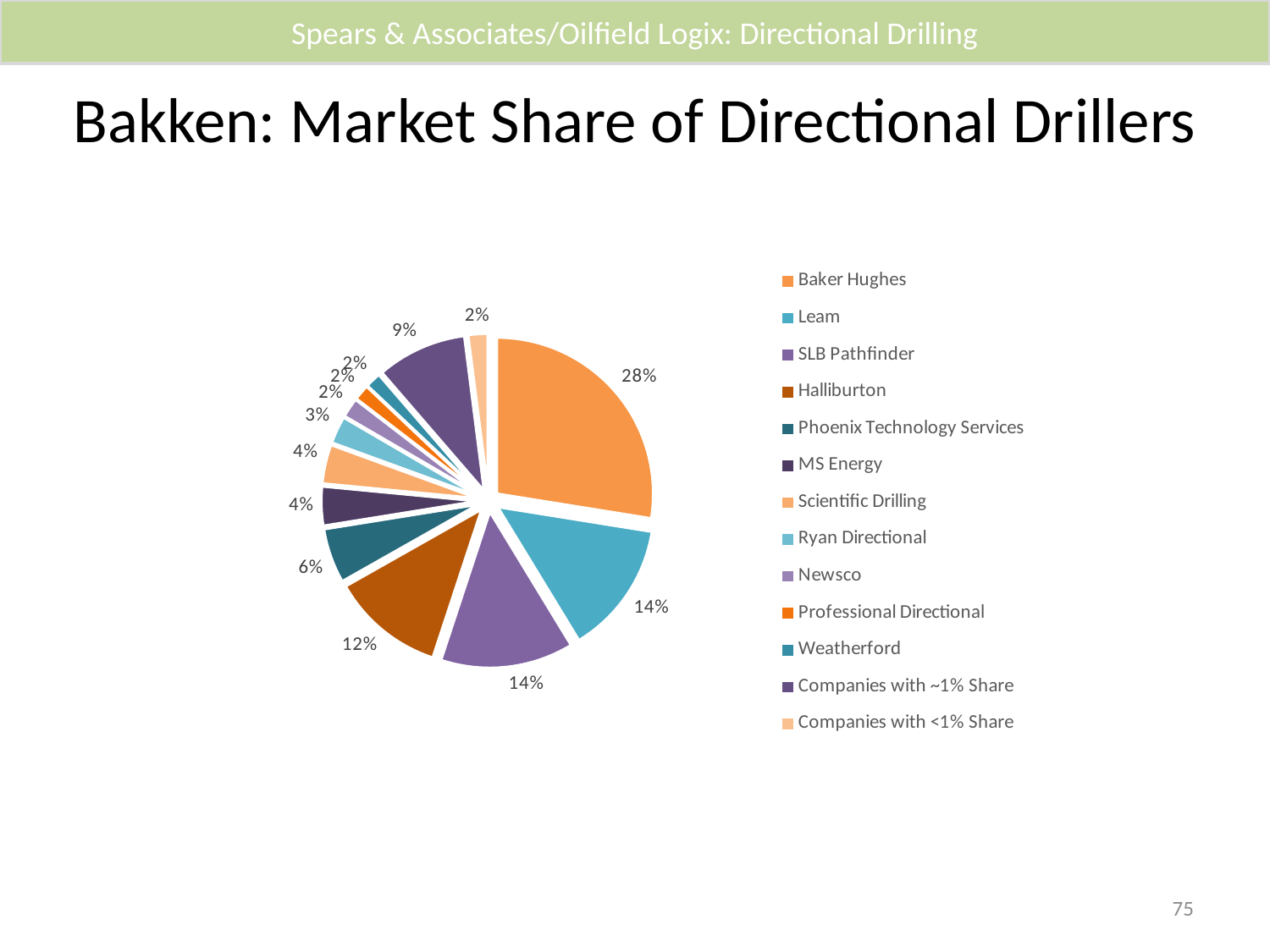
How many entries does the legend list? 13 What is the market share of Baker Hughes? 28% What is the market share of Halliburton? 12% What is the market share of Phoenix Technology Services? 6% Which company has the largest market share? Baker Hughes What type of chart is shown on the slide? pie chart What is the market share of Ryan Directional? 3% Which has a larger market share, Halliburton or Phoenix Technology Services? Halliburton What is the difference in market share between Leam and Scientific Drilling? 10% What is the market share of Companies with ~1% Share? 9% What is the difference in market share between Baker Hughes and Halliburton? 16% What is the title of the slide's chart? Bakken: Market Share of Directional Drillers